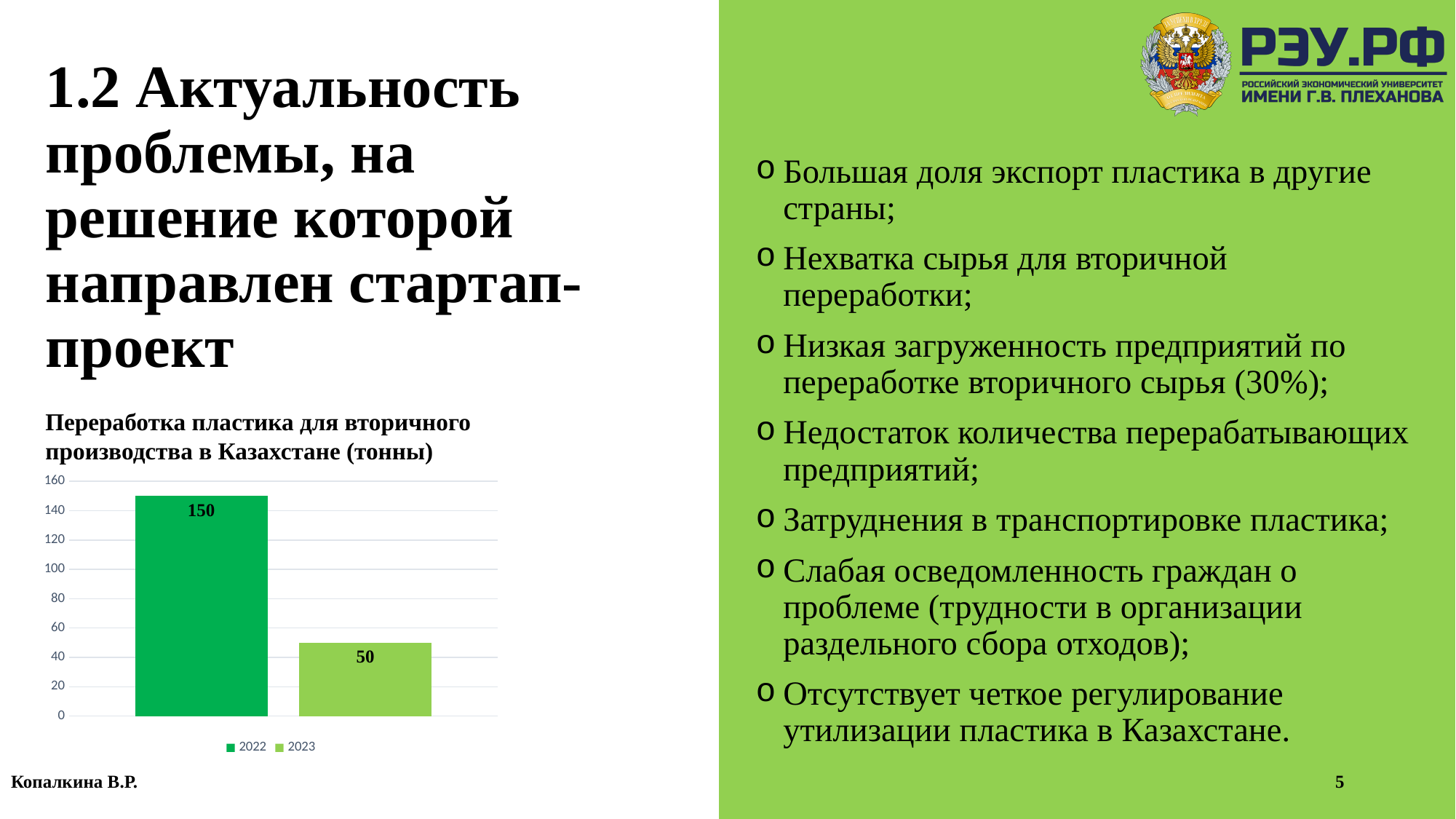
What is the value for 2023 in the chart? 50 Is the value for 2023 greater or less than 100? less Which year has the lowest value in the chart? 2023 What is the difference between the 2022 and 2023 values? 100 Do the values rise or fall from 2022 to 2023? fall How many series does the chart legend list? 2 How many bars are plotted in the chart? 2 Which is larger, the value for 2022 or the value for 2023? 2022 Which year has the highest value in the chart? 2022 What kind of chart is shown on the slide? bar chart What is the value for 2022 in the chart? 150 What is the title of the chart? Переработка пластика для вторичного производства в Казахстане (тонны)